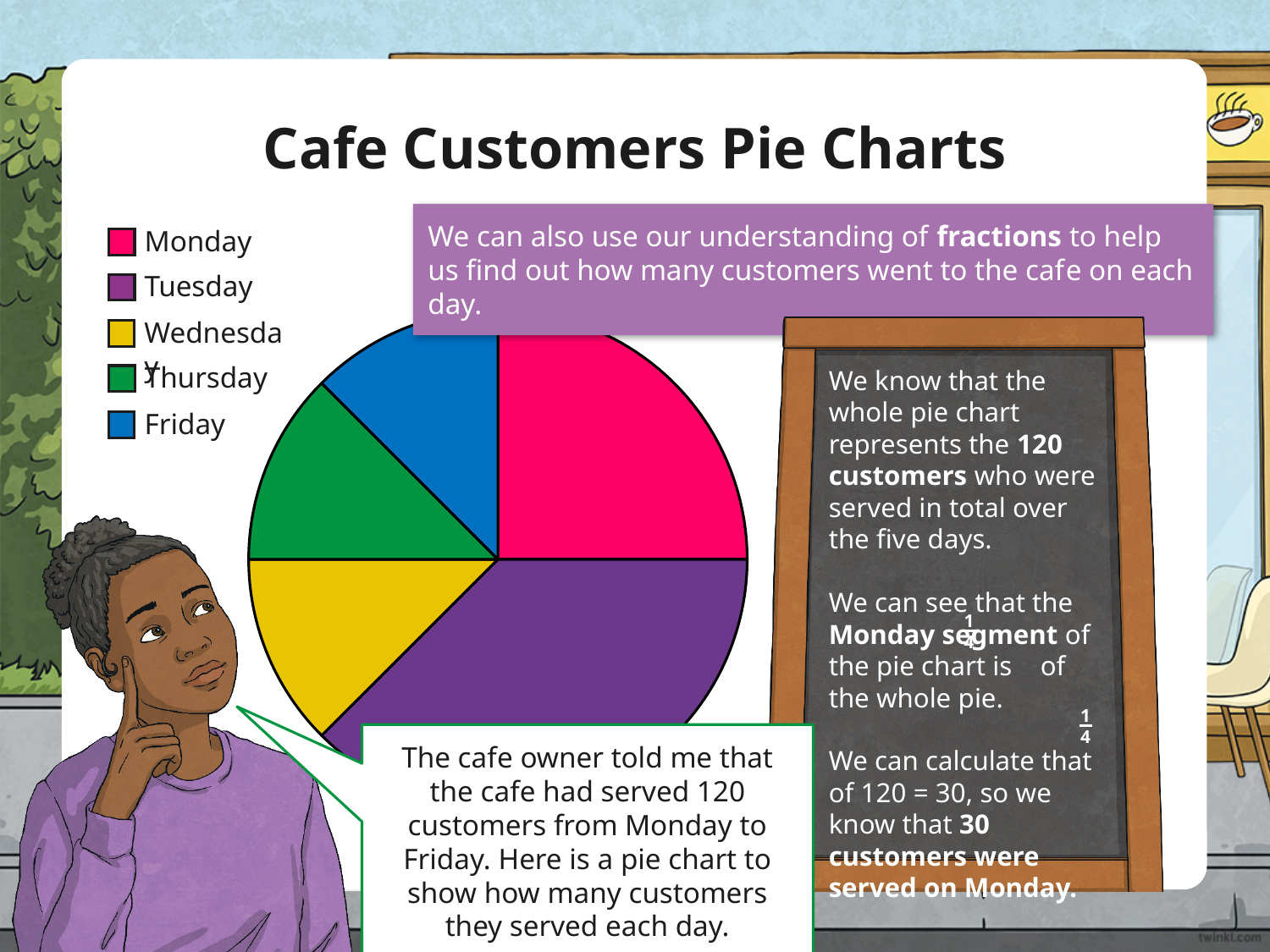
Which day is shown in blue in the pie chart? Friday Which day has the largest segment in the pie chart? Tuesday Which segment is larger, Monday or Wednesday? Monday How many segments does the pie chart have? 5 What kind of chart is shown on the slide? pie chart What is the title of the slide? Cafe Customers Pie Charts What fraction of the whole pie does the Monday segment represent? 1/4 How many customers were served on Monday? 30 How many entries does the legend list? 5 How many customers in total does the whole pie chart represent? 120 Which segment is larger, Tuesday or Friday? Tuesday